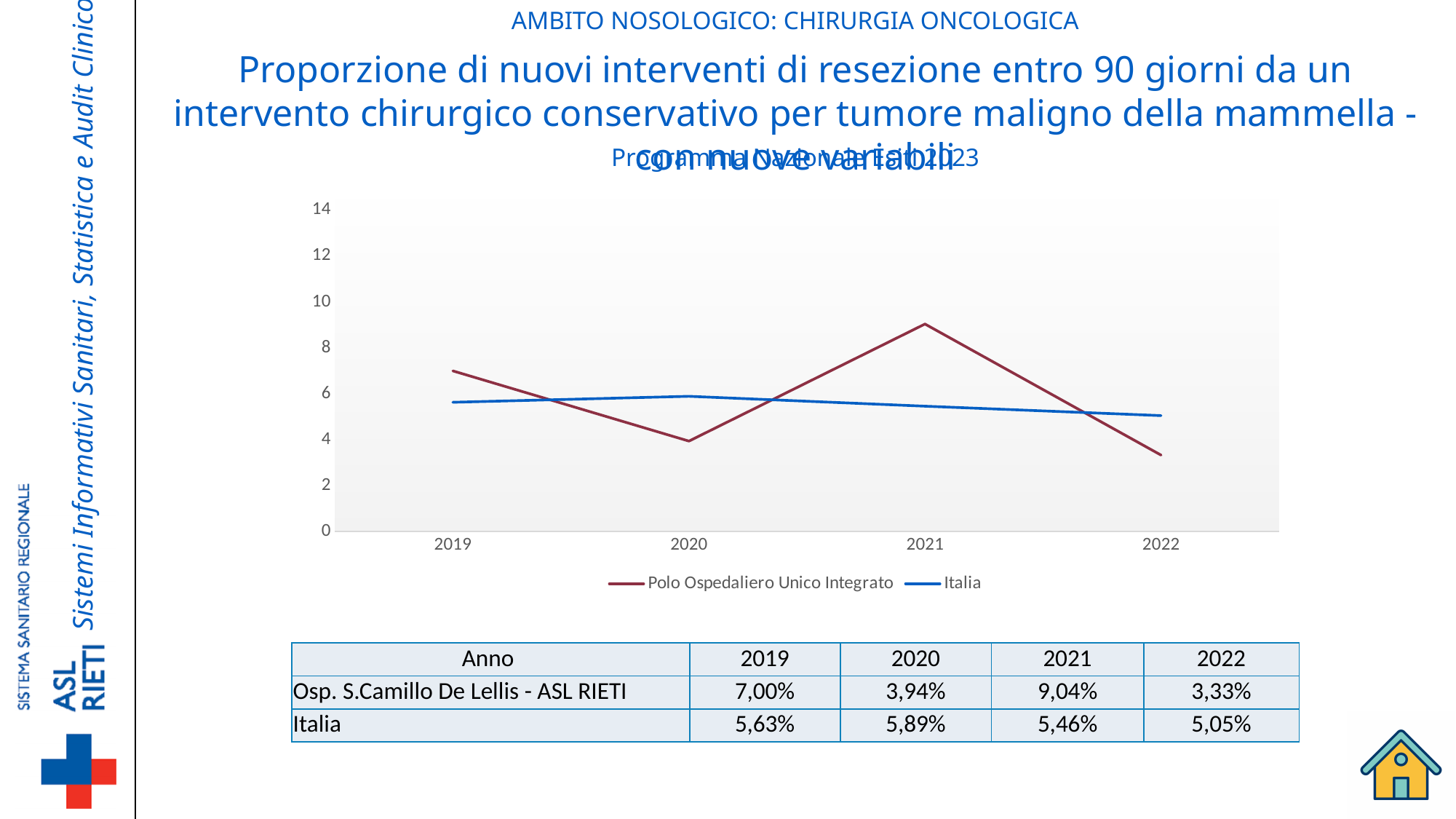
Is the value for Polo Ospedaliero Unico Integrato in 2021 greater or less than 8? greater In 2021, which series has the larger value, Polo Ospedaliero Unico Integrato or Italia? Polo Ospedaliero Unico Integrato Does the Italia line rise or fall from 2020 to 2022? fall According to the table below the chart, what is the value for Osp. S.Camillo De Lellis - ASL RIETI in 2021? 9,04% How many series does the chart legend list? 2 How many years are plotted along the x axis of the chart? 4 According to the table below the chart, what is the value for Italia in 2020? 5,89% In which year does the Polo Ospedaliero Unico Integrato line reach its highest value? 2021 What kind of chart is shown on the slide? line chart According to the table below the chart, what is the value for Osp. S.Camillo De Lellis - ASL RIETI in 2022? 3,33% What colour is the Italia line in the chart? blue In which year does the Polo Ospedaliero Unico Integrato line reach its lowest value? 2022